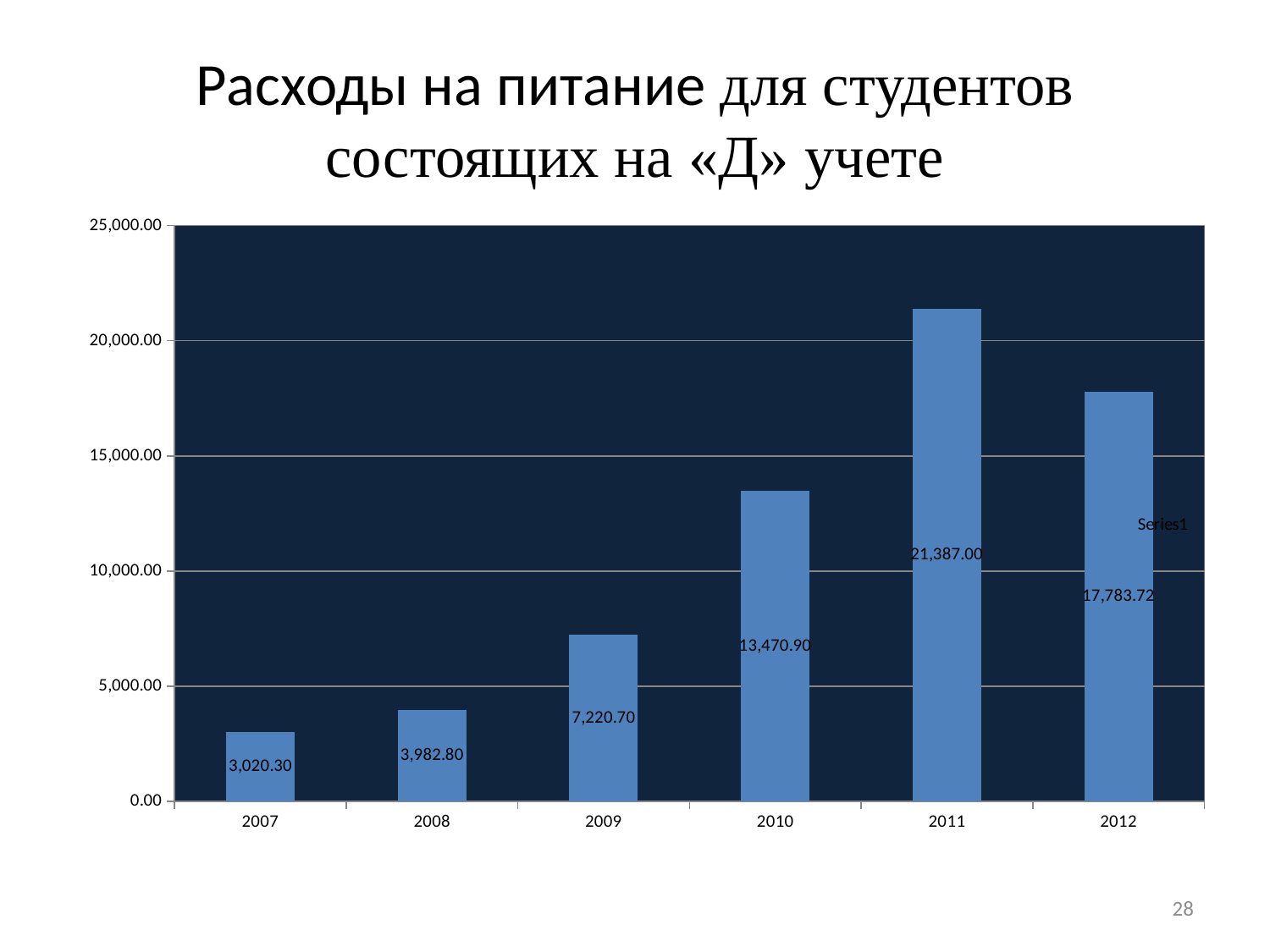
Which year has the lowest value? 2007 What is the value for 2007? 3,020.30 Which is larger, the value for 2009 or the value for 2010? 2010 What is the difference between the values for 2011 and 2012? 3,603.28 Which year has the highest value? 2011 What is the value for 2012? 17,783.72 How many years are shown on the x axis? 6 What is the difference between the values for 2008 and 2007? 962.50 What is the value for 2010? 13,470.90 Is the value for 2011 greater or less than 20,000.00? greater What kind of chart is shown on the slide? bar chart What is the name of the series shown in the legend? Series1